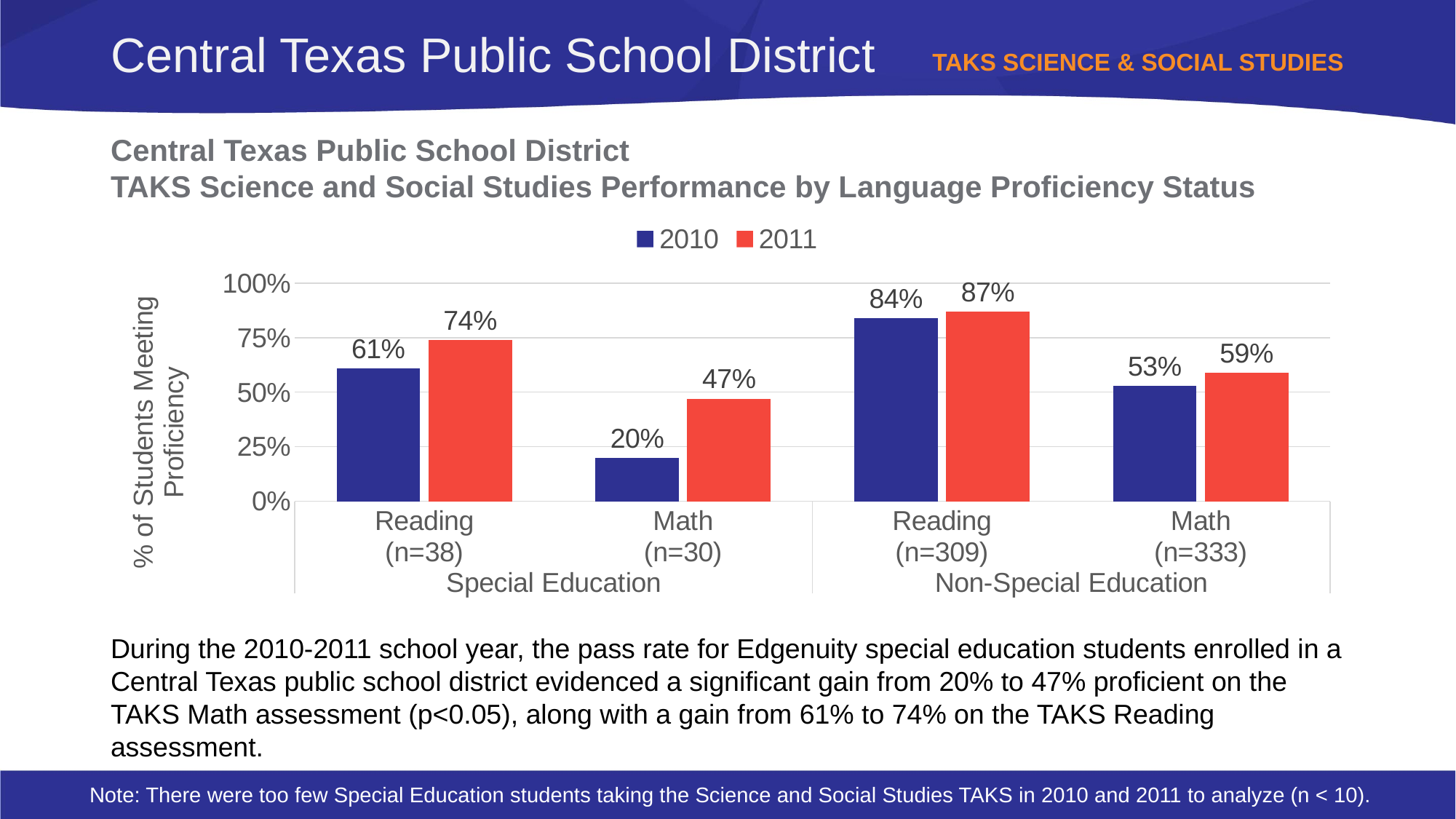
What kind of chart is shown on the slide? Bar chart What was the 2011 value for Special Education Reading (n=38)? 74% What was the 2011 value for Non-Special Education Reading (n=309)? 87% What is the difference between the 2011 and 2010 values for Non-Special Education Math (n=333)? 6% What was the 2010 value for Non-Special Education Math (n=333)? 53% Which category has the highest 2011 value? Non-Special Education Reading (n=309) How many series does the legend list? 2 What is the label of the vertical axis? % of Students Meeting Proficiency Which category has the lowest 2010 value? Special Education Math (n=30) What is the difference between the 2011 and 2010 values for Special Education Math (n=30)? 27% What was the 2010 value for Special Education Math (n=30)? 20% Which is larger: the 2010 value for Special Education Reading (n=38) or the 2010 value for Non-Special Education Math (n=333)? Special Education Reading (n=38)